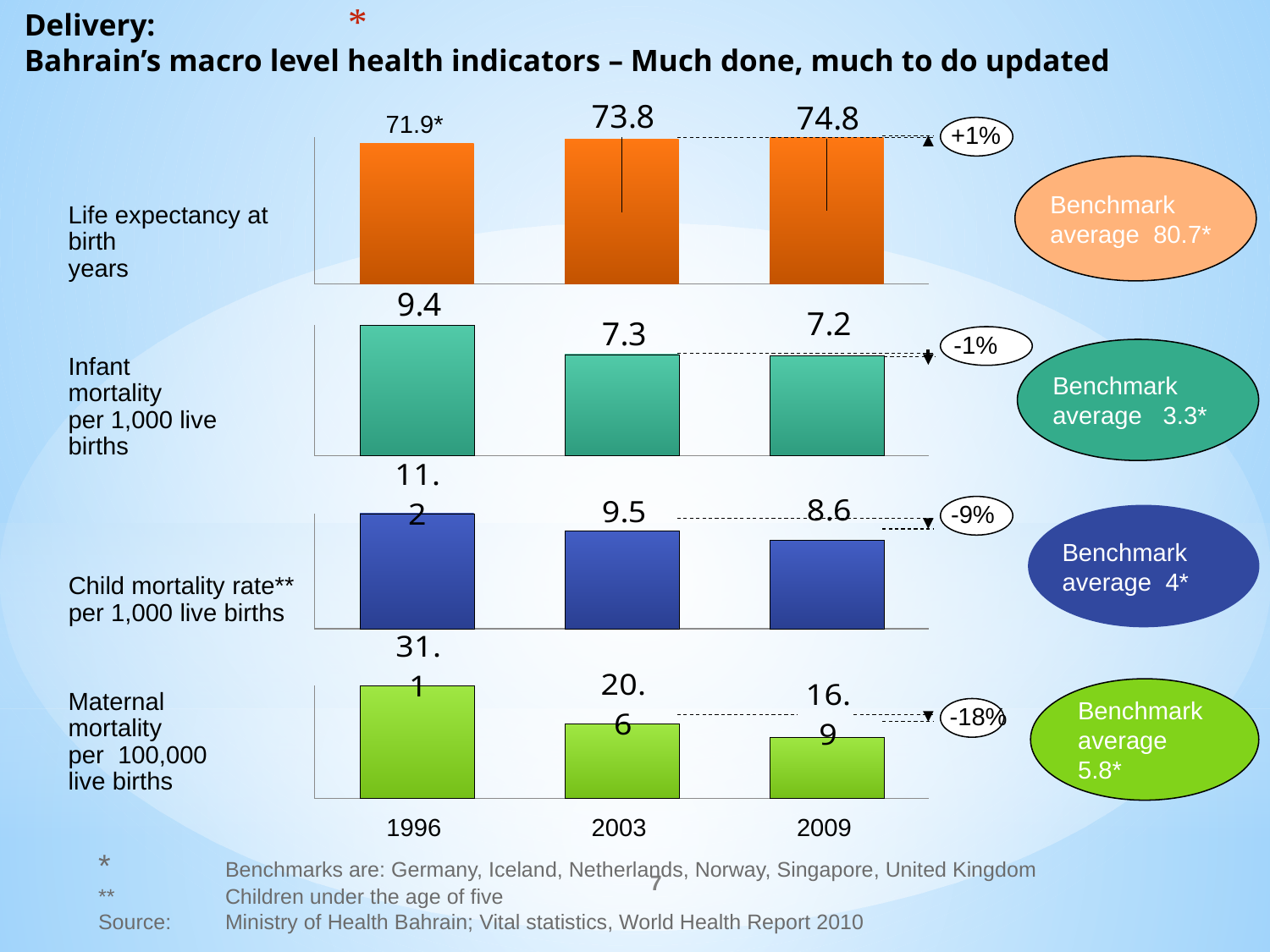
In the Infant mortality chart, what is the difference between the 1996 value and the 2009 value? 2.2 In the Infant mortality chart, what is the value for 1996? 9.4 How many years are shown on the x axis of the charts? 3 In the Life expectancy at birth chart, which year has the lowest value? 1996 In the Child mortality rate chart, what is the value for 2003? 9.5 In the Child mortality rate chart, is the value for 1996 larger or smaller than the value for 2009? larger In the Life expectancy at birth chart, what is the value for 2009? 74.8 What type of chart is used to show Maternal mortality? bar chart What benchmark average is shown next to the Infant mortality chart? 3.3* In the Maternal mortality chart, which year has the highest value? 1996 In the Life expectancy at birth chart, do the values rise or fall from 1996 to 2009? rise In the Maternal mortality chart, what is the value for 2009? 16.9